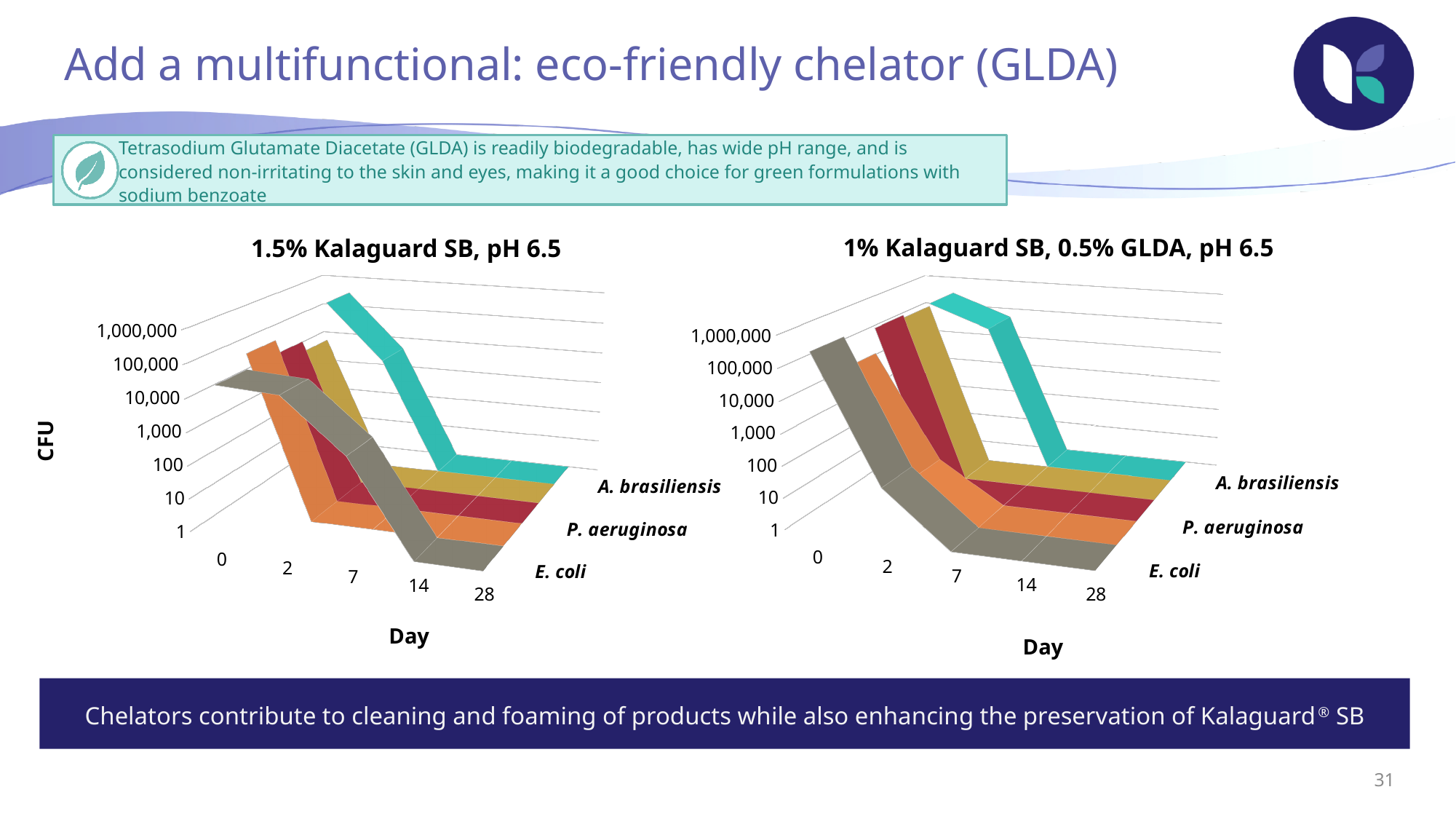
In the right chart (1% Kalaguard SB, 0.5% GLDA, pH 6.5), do the CFU values rise or fall from day 0 to day 28? fall In the right chart (1% Kalaguard SB, 0.5% GLDA, pH 6.5), what is the lowest tick value shown on the CFU axis? 1 What is the title of the chart on the right? 1% Kalaguard SB, 0.5% GLDA, pH 6.5 In the right chart (1% Kalaguard SB, 0.5% GLDA, pH 6.5), how many day points are shown on the x axis? 5 In the left chart (1.5% Kalaguard SB, pH 6.5), what kind of chart is used? 3D line chart In the left chart (1.5% Kalaguard SB, pH 6.5), what is the highest tick value shown on the CFU axis? 1,000,000 In the left chart (1.5% Kalaguard SB, pH 6.5), what is the last day shown on the x axis? 28 What is the title of the chart on the left? 1.5% Kalaguard SB, pH 6.5 In the left chart (1.5% Kalaguard SB, pH 6.5), do the CFU values rise or fall from day 0 to day 28? fall In the left chart (1.5% Kalaguard SB, pH 6.5), how many day points are shown on the x axis? 5 How many charts are shown on the slide? 2